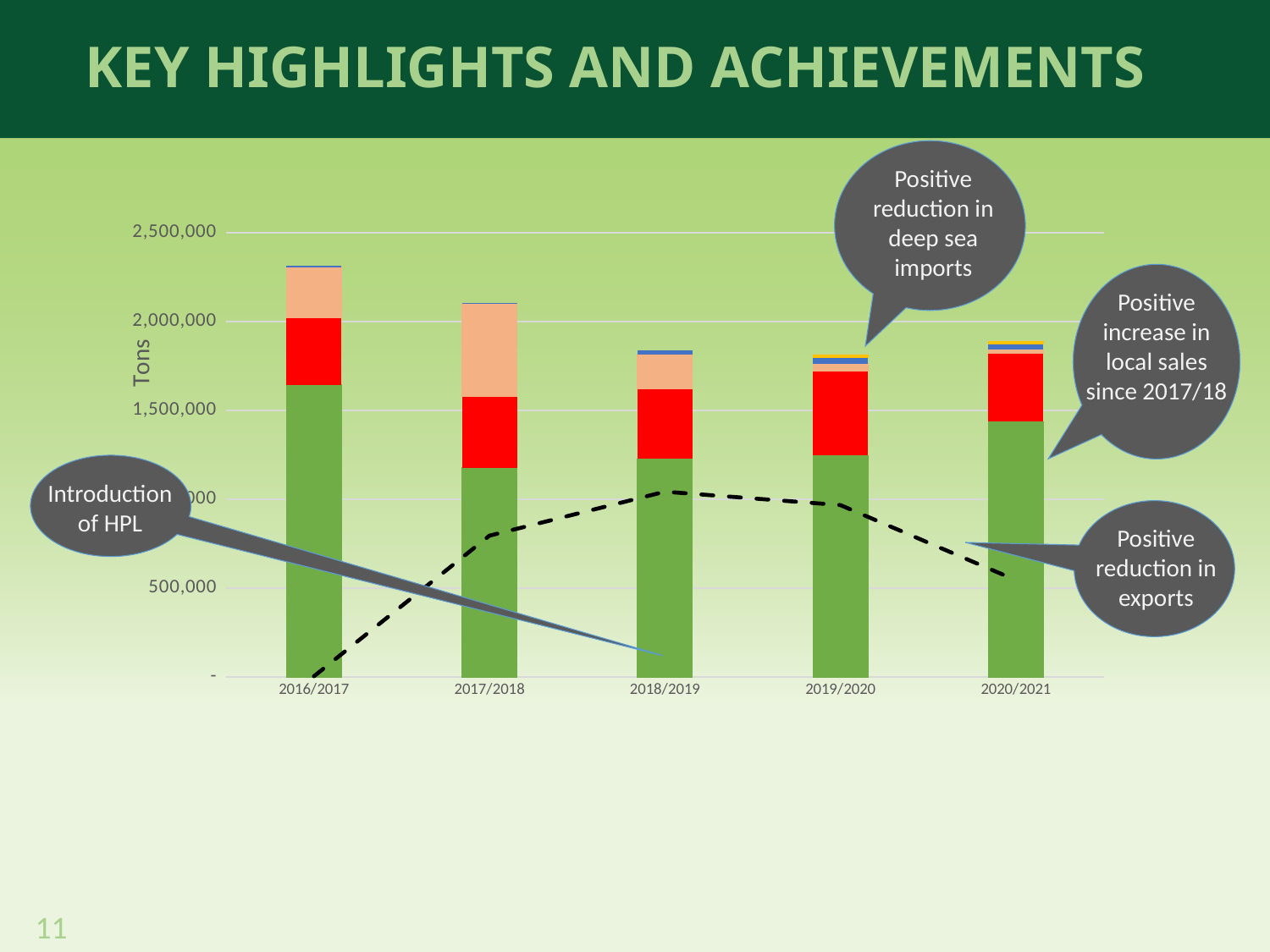
What is the label on the vertical axis? Tons How many fiscal-year categories are shown on the x axis? 5 Is the total stacked bar for 2016/2017 greater or less than 2,000,000? greater Which year has the larger total stacked bar, 2016/2017 or 2020/2021? 2016/2017 Which year has the tallest stacked bar overall? 2016/2017 Is the green segment for 2017/2018 greater or less than 1,500,000? less Is the total stacked bar for 2020/2021 greater or less than 2,000,000? less How does the dashed line move from 2016/2017 to 2020/2021? rises then falls What kind of chart is shown on the slide? combination bar and line chart Which year has the largest green segment? 2016/2017